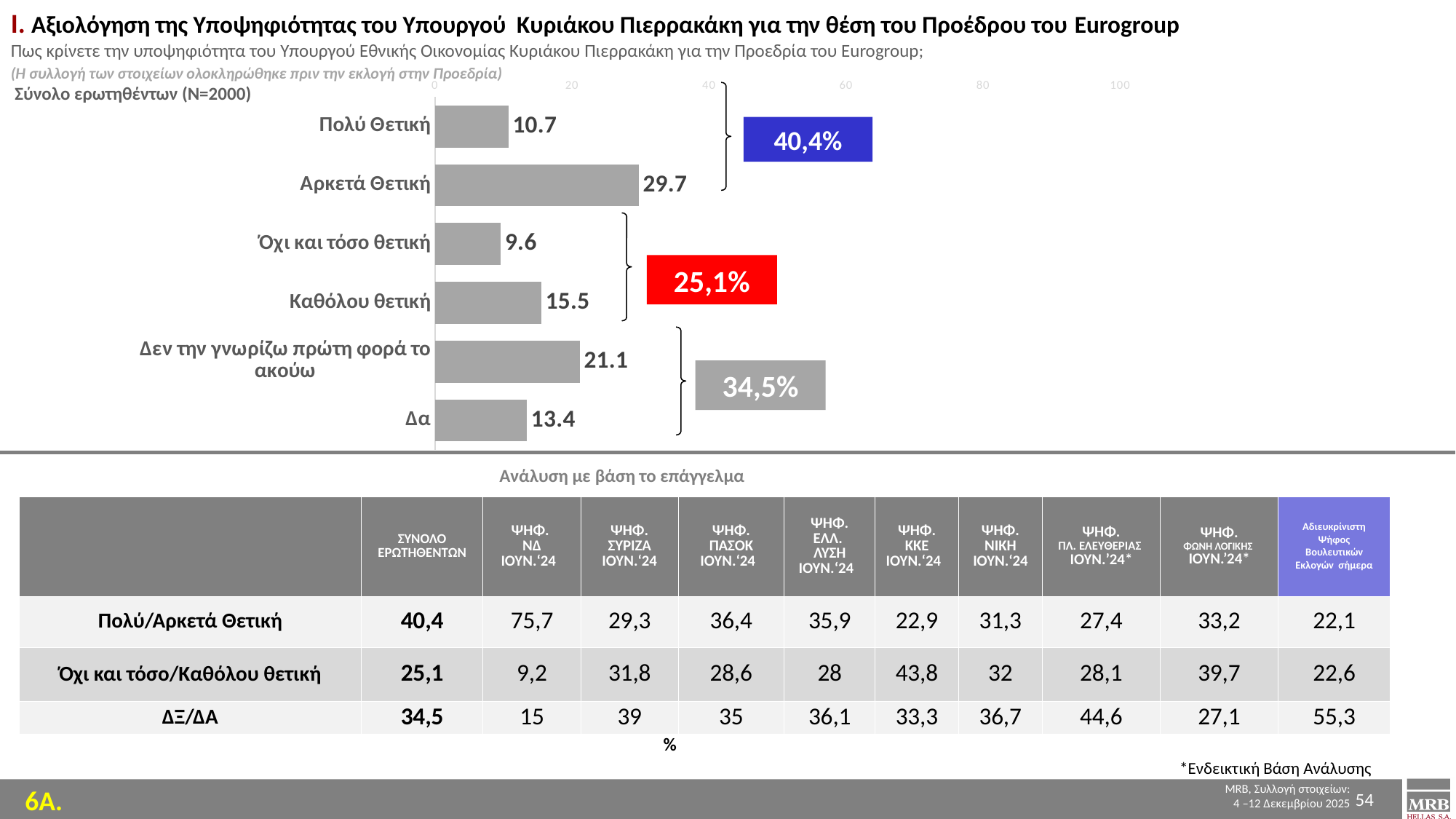
Which is larger, the value for "Καθόλου θετική" or the value for "Δα"? Καθόλου θετική What value is shown for the bar labelled "Δεν την γνωρίζω πρώτη φορά το ακούω"? 21.1 What is the difference between the values for "Αρκετά Θετική" and "Πολύ Θετική"? 19.0 How many categories (bars) are plotted in the bar chart? 6 What value is shown for the bar labelled "Καθόλου θετική"? 15.5 What value is shown for the bar labelled "Αρκετά Θετική"? 29.7 What kind of chart is shown on the slide? bar chart Which category has the lowest value in the bar chart? Όχι και τόσο θετική What combined percentage is shown in the blue box for the two positive categories ("Πολύ Θετική" and "Αρκετά Θετική")? 40,4% What combined percentage is shown in the red box for the two negative categories ("Όχι και τόσο θετική" and "Καθόλου θετική")? 25,1% Is the value for "Δεν την γνωρίζω πρώτη φορά το ακούω" greater or less than 20? greater Which category has the highest value in the bar chart? Αρκετά Θετική